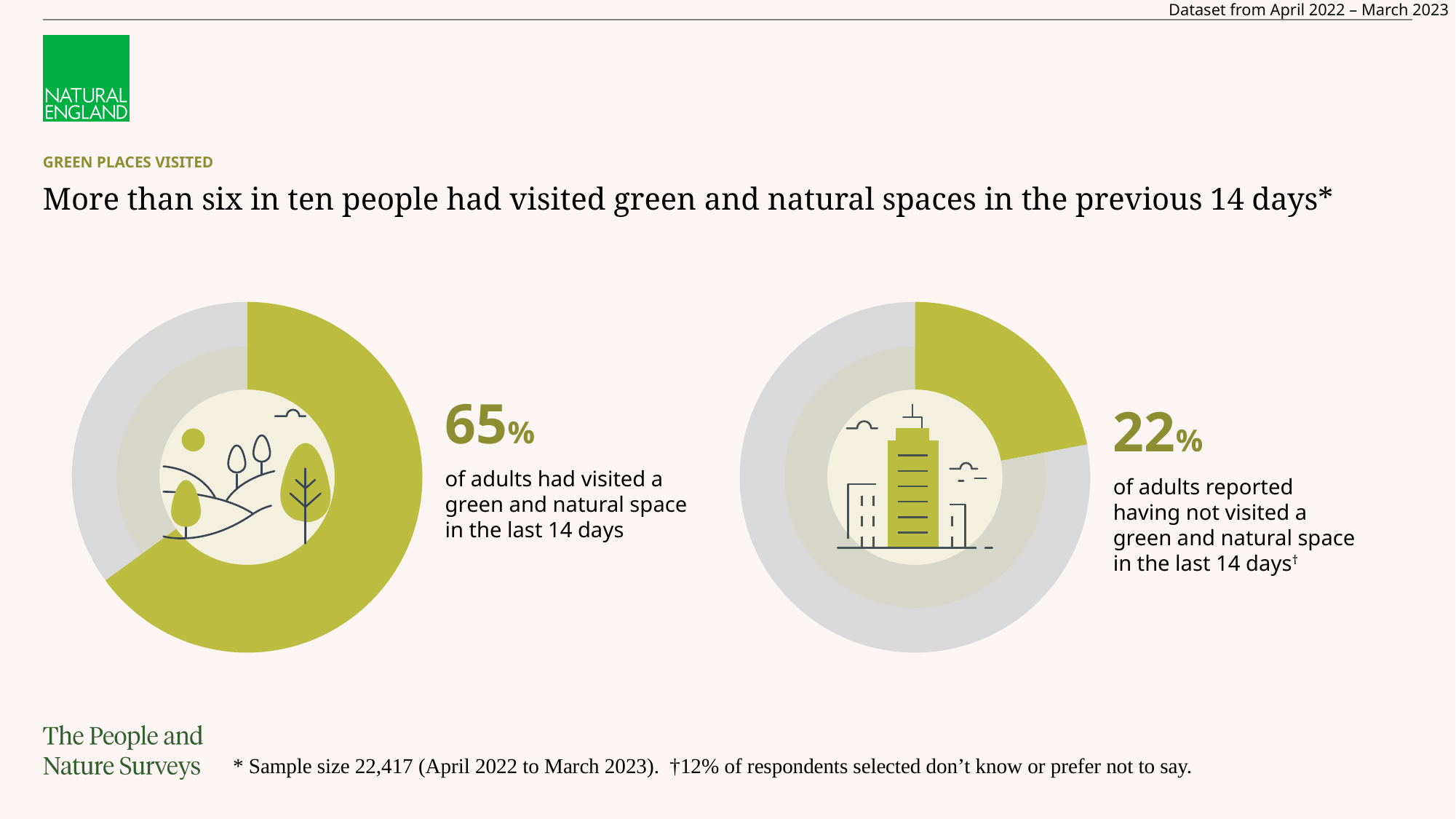
Which is larger: the share of adults who had visited a green and natural space (left chart) or the share who had not (right chart)? Had visited (65%) How many donut charts are shown on the slide? 2 What kind of chart is used on the right of the slide to show the 22% figure? Donut (pie) chart What colour is used for the highlighted slice in both donut charts? Green (olive/lime green) On the right chart, what percentage of adults reported having not visited a green and natural space in the last 14 days? 22% On the left chart, is the highlighted green slice greater or less than half of the donut? greater What is the sample size stated in the footnote of the slide? 22,417 What is the difference in percentage points between the 65% on the left chart and the 22% on the right chart? 43 percentage points What kind of chart is used on the left of the slide to show the 65% figure? Donut (pie) chart On the left chart, what percentage of adults had visited a green and natural space in the last 14 days? 65% According to the footnote, what percentage of respondents selected don't know or prefer not to say? 12% On the right chart, is the highlighted green slice greater or less than half of the donut? less